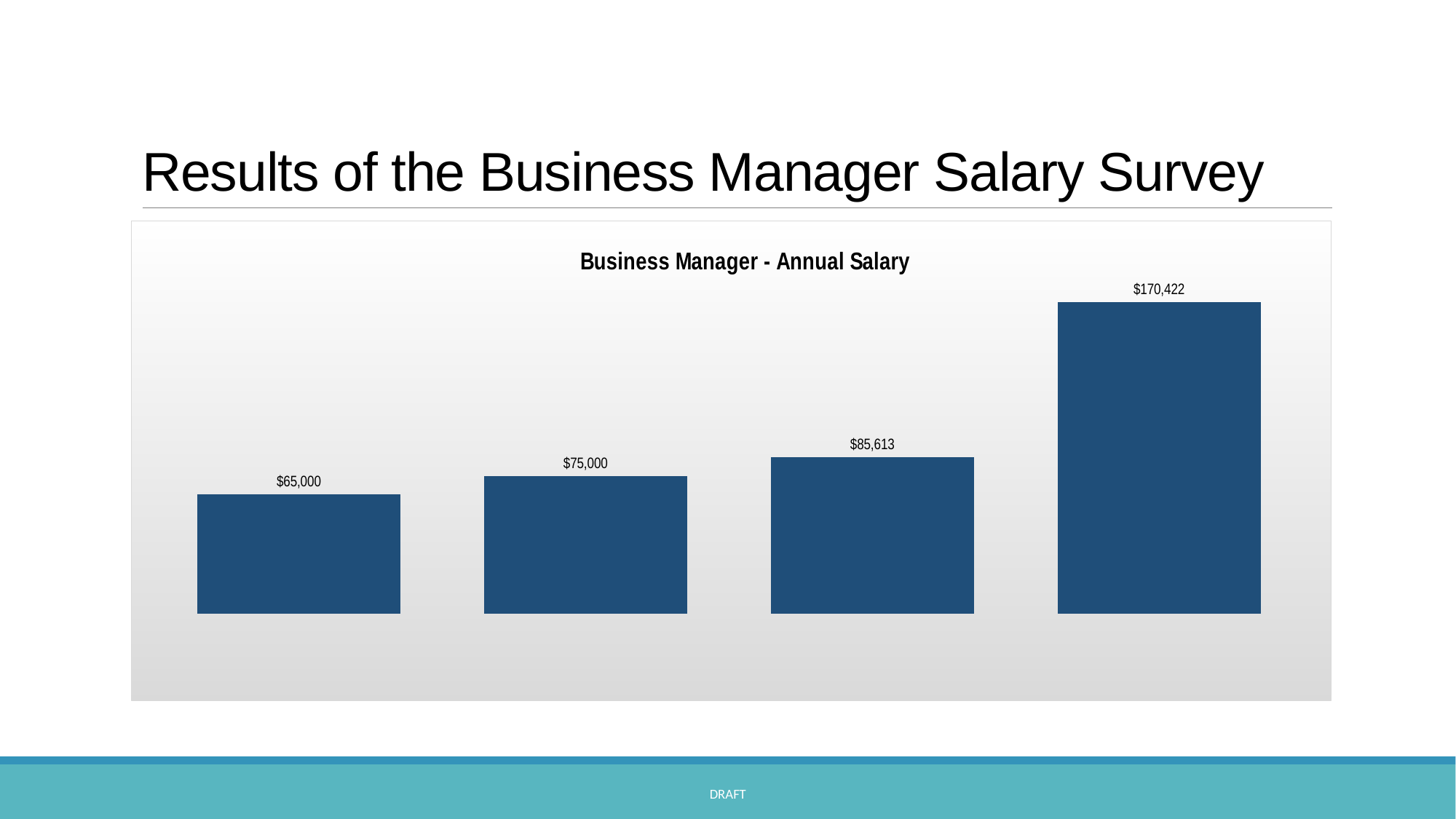
What is the value shown on the second bar from the left? $75,000 What is the difference between the rightmost bar and the leftmost bar? $105,422 What is the title of the chart? Business Manager - Annual Salary What is the value shown on the leftmost bar? $65,000 What is the value shown on the rightmost bar? $170,422 What kind of chart is shown on the slide? bar chart Which is larger, the second bar from the left or the third bar from the left? the third bar from the left Do the bar values rise or fall from left to right? rise How many bars are plotted in the chart? 4 What is the highest value shown in the chart? $170,422 What is the lowest value shown in the chart? $65,000 What is the value shown on the third bar from the left? $85,613